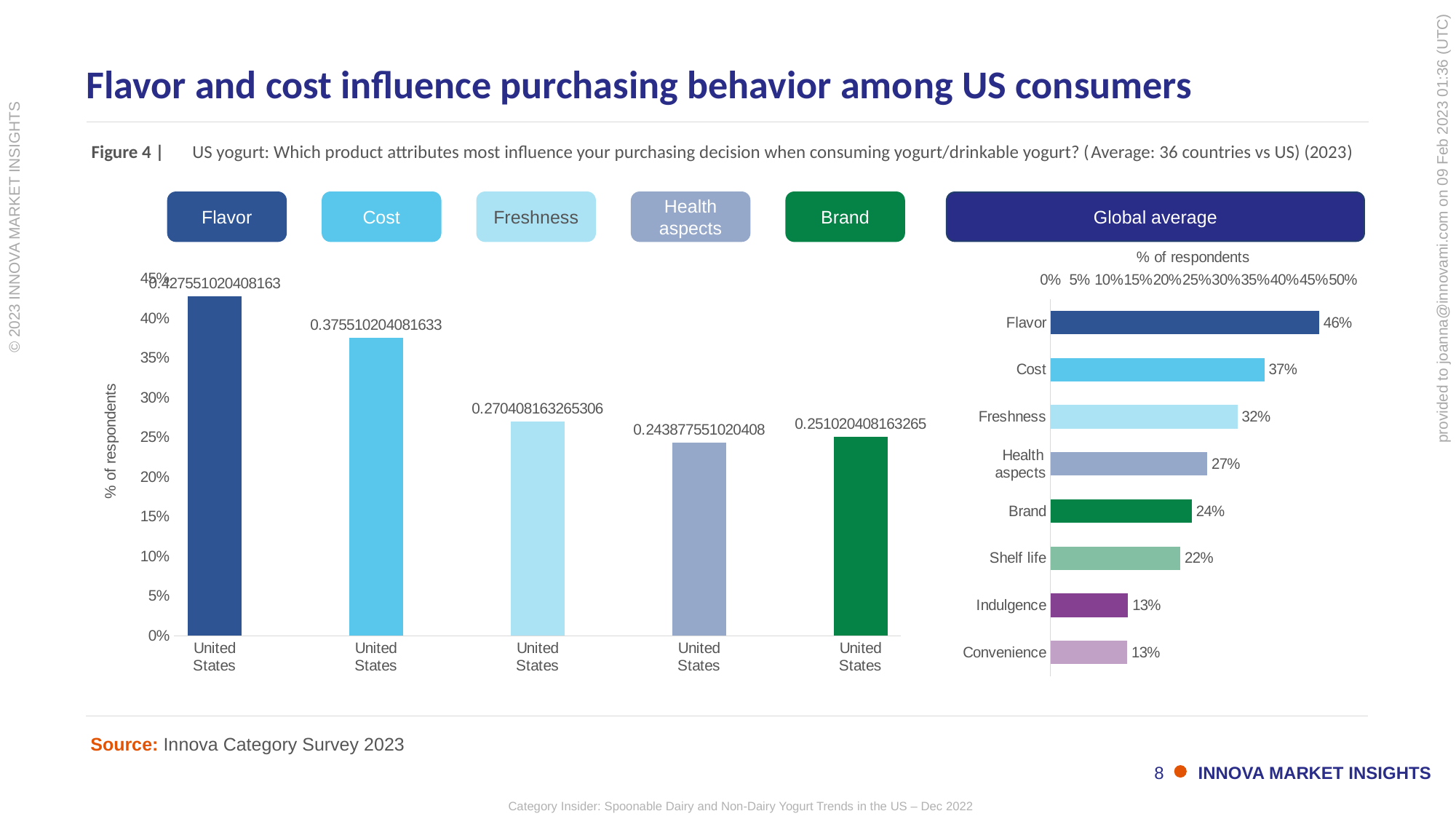
What kind of chart is the Global average chart on the right? Bar chart In the Global average chart, which attribute has the highest value? Flavor In the left-hand United States chart, what is the value printed above the green Brand bar? 0.251020408163265 In the left-hand United States chart, what is the value printed above the dark blue Flavor bar? 0.427551020408163 How many bars are plotted in the left-hand United States chart? 5 In the Global average chart, what is the difference between the values for Flavor and Cost? 9 percentage points In the left-hand United States chart, which is larger, the value for Brand or the value for Health aspects? Brand In the left-hand United States chart, is the value for the Cost bar greater or less than 35%? greater In the Global average chart, what is the value for Flavor? 46% In the Global average chart, which is larger, the value for Freshness or the value for Brand? Freshness In the Global average chart, what is the value for Shelf life? 22% How many attributes are plotted in the Global average chart? 8